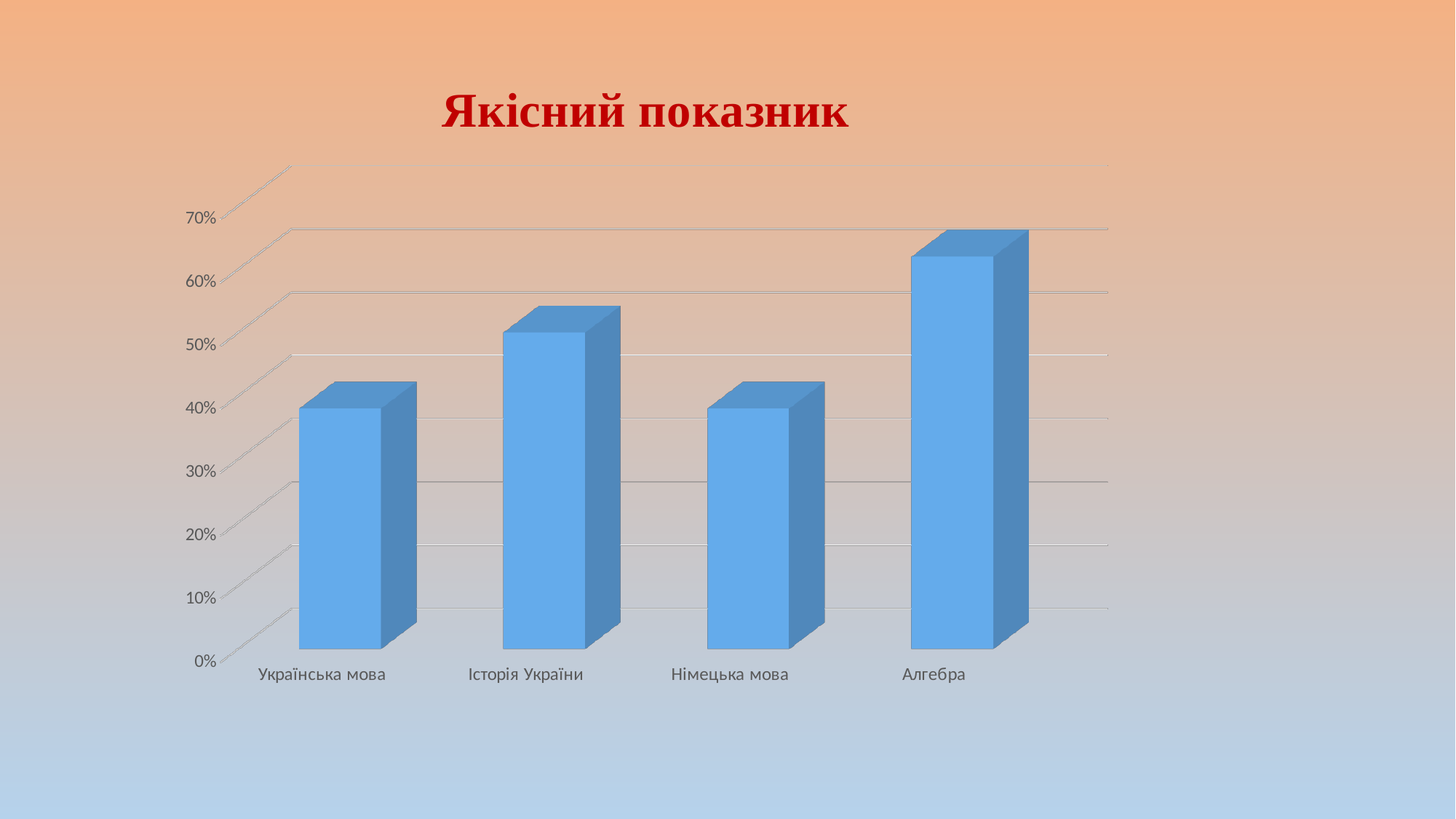
How many categories are shown on the x axis of the chart? 4 Which is larger, the value for Історія України or the value for Німецька мова? Історія України Is the value for Алгебра greater or less than 70%? less Which category has the highest value in the chart? Алгебра Is the value for Історія України greater or less than 40%? greater Is the value for Алгебра greater or less than 60%? greater What type of chart is shown on the slide? bar chart What is the title of the chart? Якісний показник Which is larger, the value for Алгебра or the value for Історія України? Алгебра